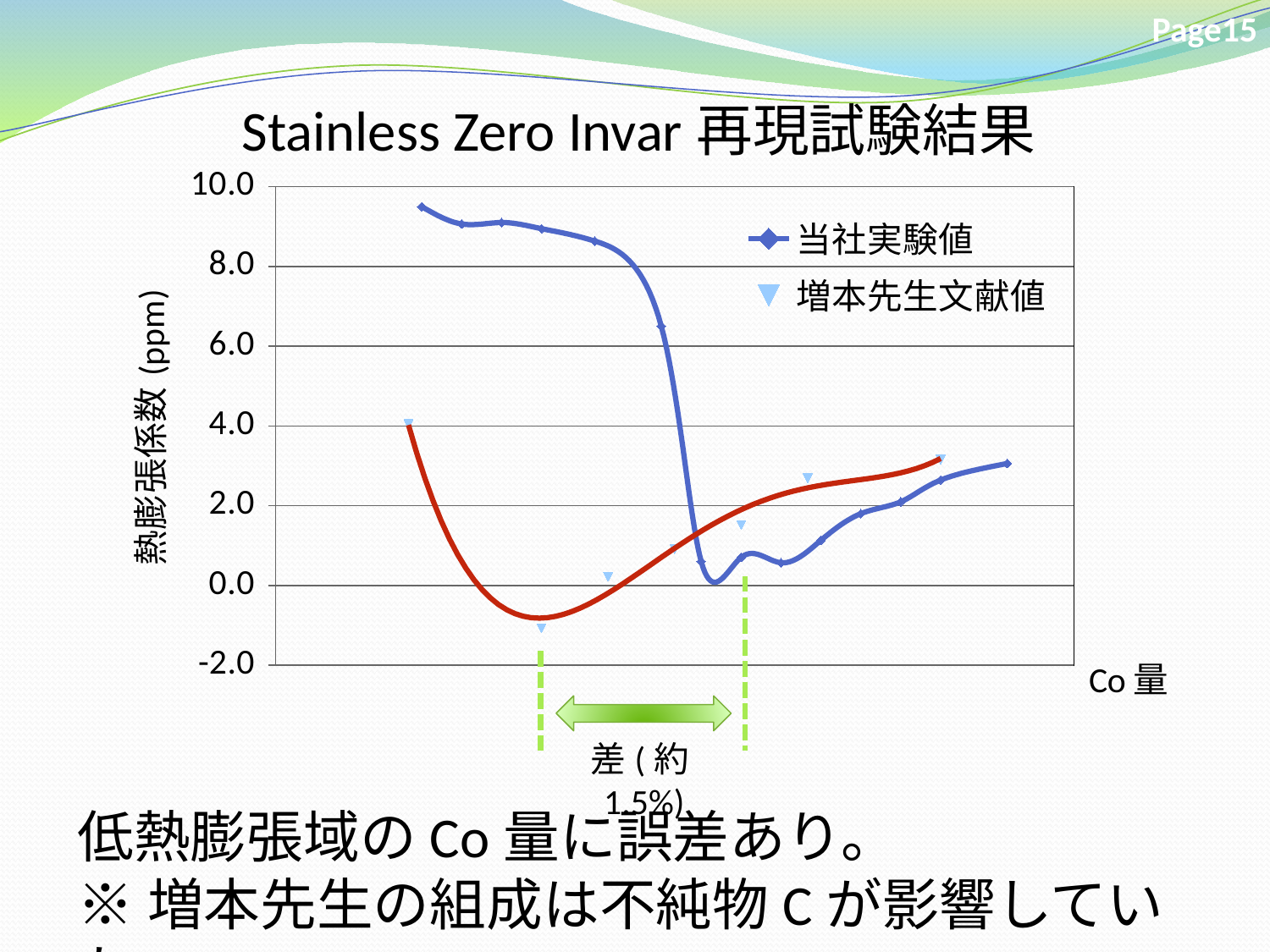
Does the 当社実験値 series rise or fall from its first point to its lowest point? fall Is the lowest value of the 当社実験値 series greater or less than 2.0? less Which series reaches the highest value on the chart? 当社実験値 Is the rightmost point of the 当社実験値 series greater or less than 4.0? less Is the highest value of the 当社実験値 series greater or less than 8.0? greater At the leftmost plotted points, which series has the larger value, 当社実験値 or 増本先生文献値? 当社実験値 How many series does the legend list? 2 Which series reaches the lowest value on the chart? 増本先生文献値 What is the label of the vertical axis? 熱膨張係数 (ppm) What kind of chart is shown on the slide? line chart What is the title of the chart? Stainless Zero Invar 再現試験結果